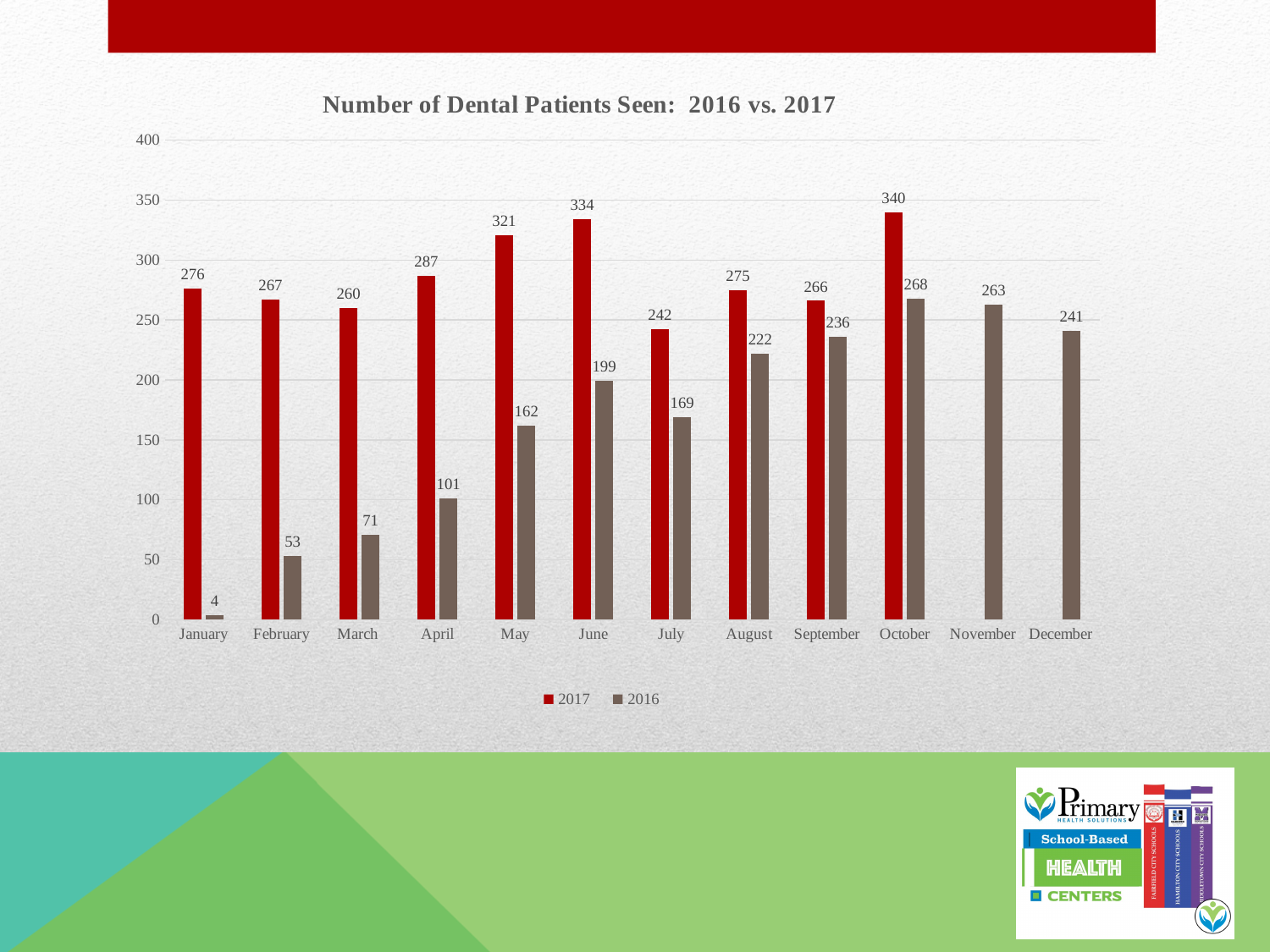
What is the difference between the 2017 and 2016 values for April? 186 What is the number of dental patients seen in November 2016? 263 Which month has the lowest value for the 2016 series? January How many series does the legend list? 2 What is the number of dental patients seen in June 2017? 334 Which month has the highest value for the 2017 series? October What kind of chart is shown on the slide? Bar chart Do the 2016 values rise or fall from January to June? Rise How many months are shown on the x axis? 12 What is the title of the chart? Number of Dental Patients Seen: 2016 vs. 2017 Which is larger, the 2016 value for September or the 2016 value for August? September What is the number of dental patients seen in January 2016? 4